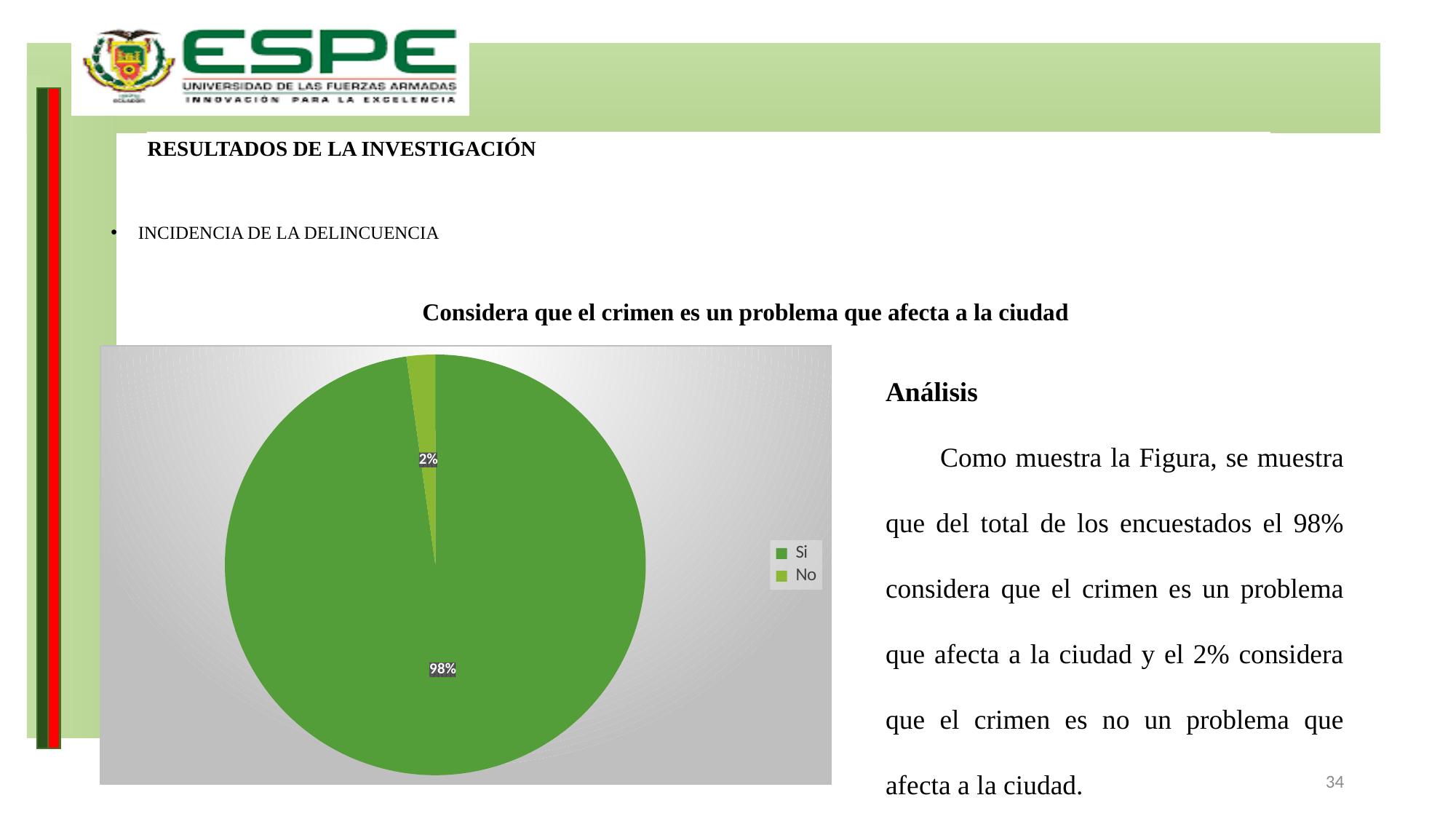
Which legend entry is shown in the lighter green colour? No What percentage of respondents answered "Si"? 98% What share of the pie does the "Si" slice represent? 98% What is the difference in percentage points between the "Si" and "No" slices? 96 What is the title of the chart? Considera que el crimen es un problema que afecta a la ciudad What percentage of respondents answered "No"? 2% Which category has the largest share of the pie? Si Which category has the smallest share of the pie? No Which slice is larger, "Si" or "No"? Si What kind of chart is shown on the slide? pie chart How many slices does the pie chart have? 2 How many entries does the legend list? 2